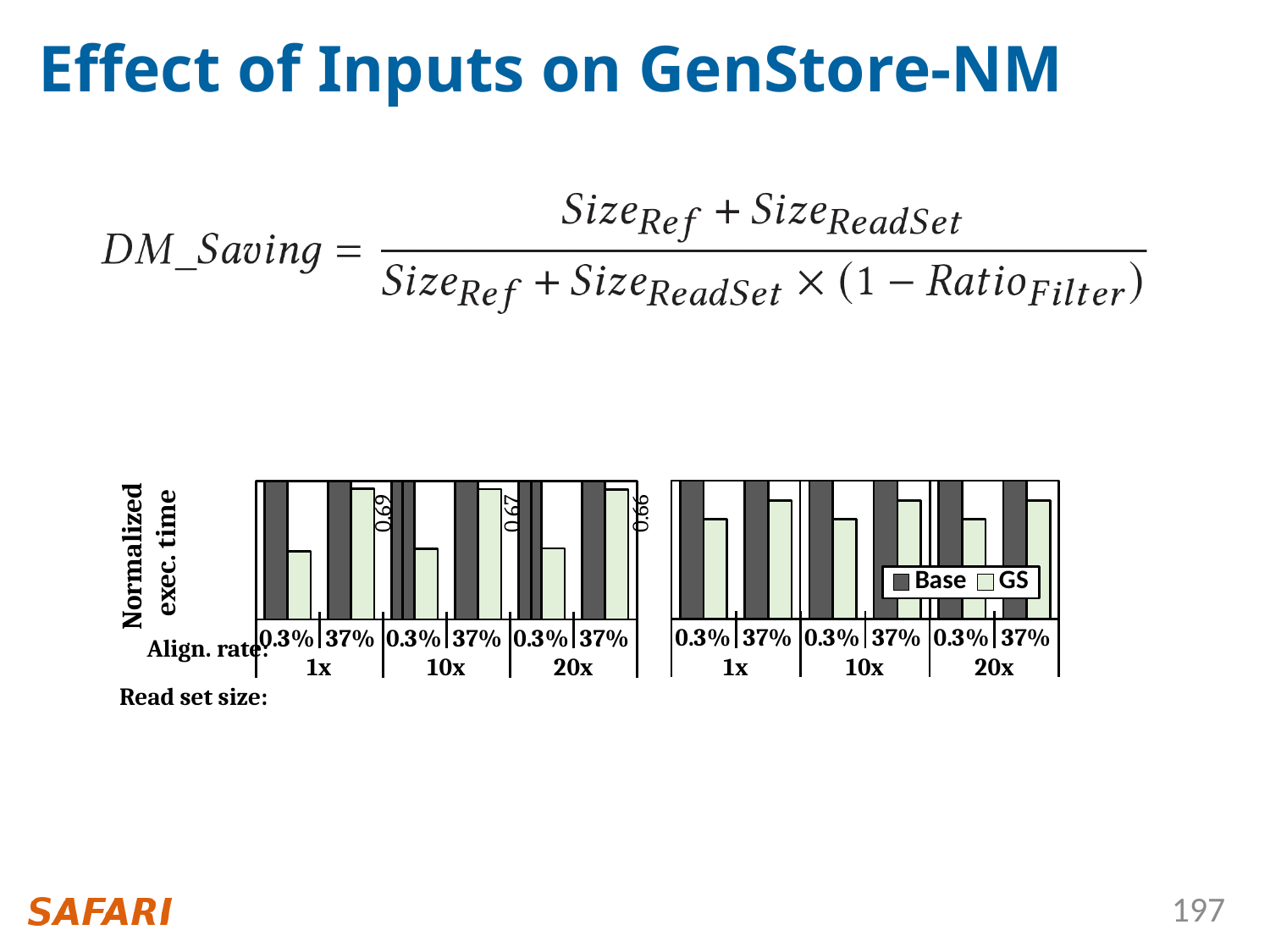
In the left chart, do the labeled GS values at 37% align rate rise or fall as the read set size increases from 1x to 20x? fall In the left chart, which read set size has the lowest labeled GS value at 37% align rate? 20x How many series does the legend list for the charts? 2 In the left chart, what is the GS value at 37% align rate with a 1x read set size? 0.69 In the left chart, what is the GS value at 37% align rate with a 10x read set size? 0.67 What kind of chart is shown on the left of the slide? bar chart In the left chart, for a 1x read set size, is the GS bar larger at 0.3% or 37% align rate? 37% What are the two series named in the legend? Base and GS In the left chart, what is the difference between the labeled GS values at 37% align rate for 1x and 20x read set sizes? 0.03 In the left chart, what is the GS value at 37% align rate with a 20x read set size? 0.66 What is the y-axis label of the charts? Normalized exec. time How many align-rate categories are shown along the x axis of the left chart? 6